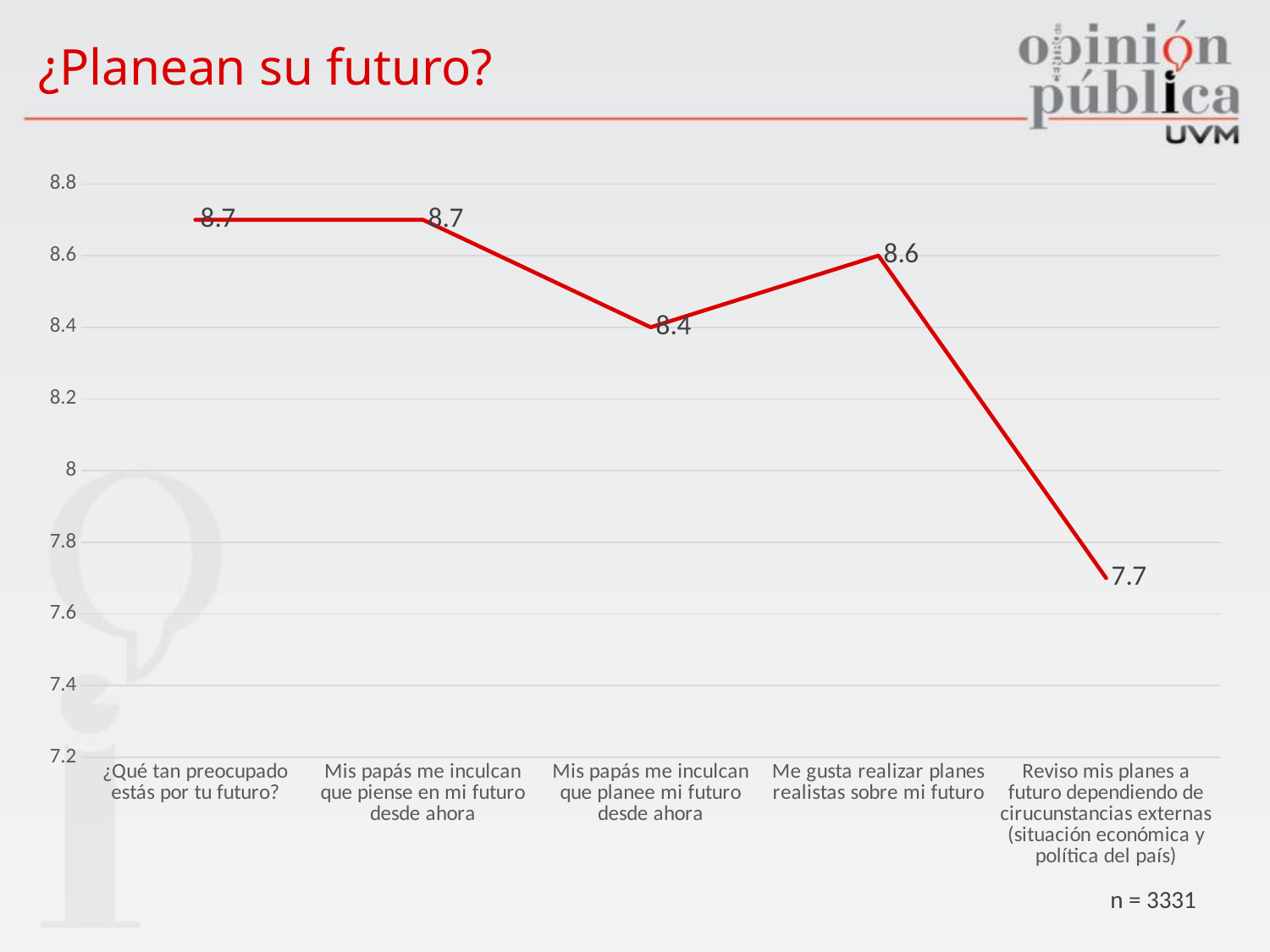
What kind of chart is shown on the slide? line chart What is the title of the slide? ¿Planean su futuro? What is the value for "Mis papás me inculcan que planee mi futuro desde ahora"? 8.4 Is the value for "Reviso mis planes a futuro dependiendo de cirucunstancias externas" greater or less than 8? less How many categories are plotted on the chart? 5 Which category has the lowest value? Reviso mis planes a futuro dependiendo de cirucunstancias externas (situación económica y política del país) What is the difference between the values for "Me gusta realizar planes realistas sobre mi futuro" and "Reviso mis planes a futuro dependiendo de cirucunstancias externas"? 0.9 What is the difference between the values for "Mis papás me inculcan que piense en mi futuro desde ahora" and "Mis papás me inculcan que planee mi futuro desde ahora"? 0.3 What is the value for "Me gusta realizar planes realistas sobre mi futuro"? 8.6 What is the value for "Reviso mis planes a futuro dependiendo de cirucunstancias externas (situación económica y política del país)"? 7.7 Which is larger, the value for "Mis papás me inculcan que planee mi futuro desde ahora" or the value for "Me gusta realizar planes realistas sobre mi futuro"? Me gusta realizar planes realistas sobre mi futuro What is the value for "¿Qué tan preocupado estás por tu futuro?"? 8.7